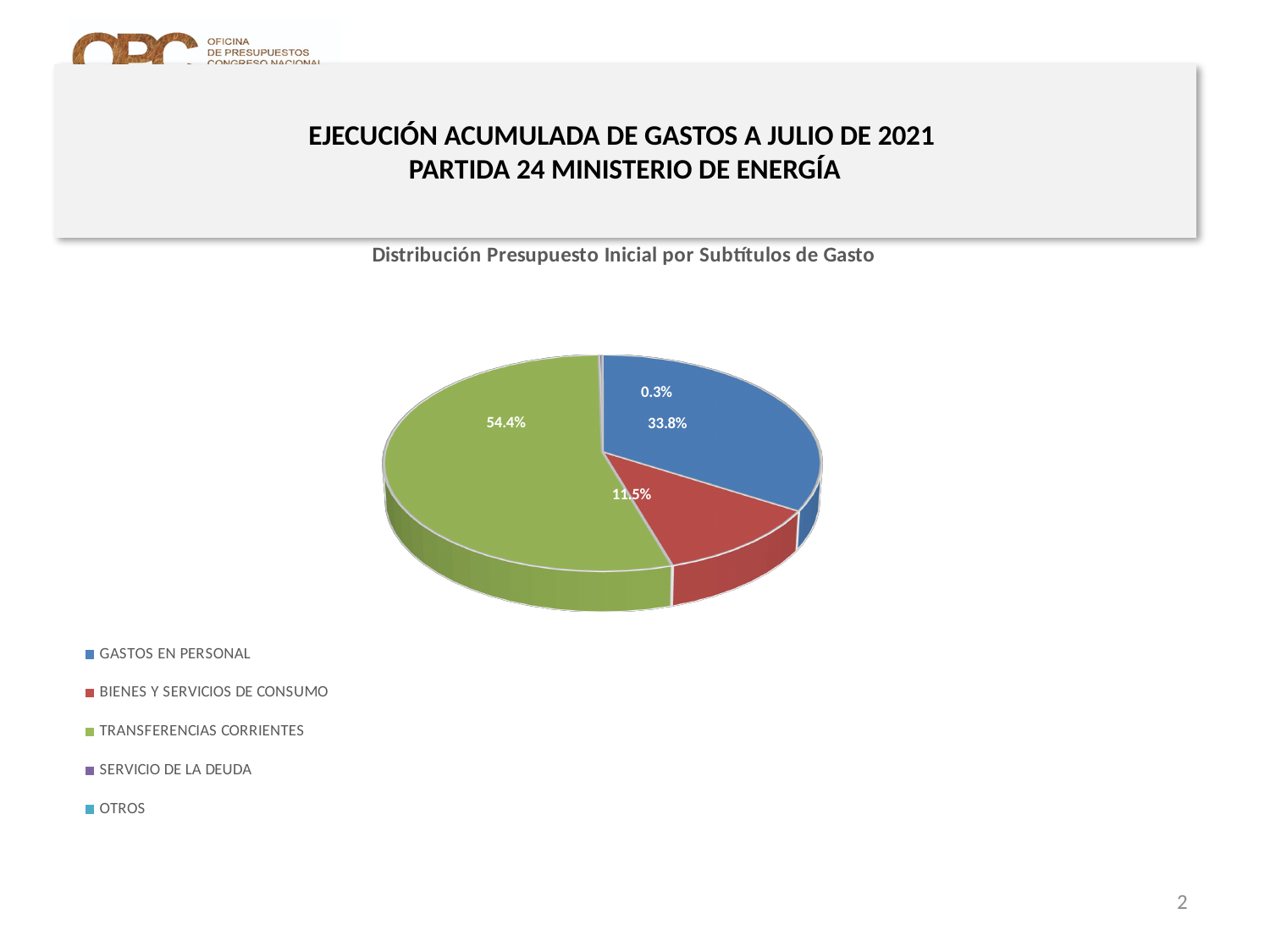
Which is larger, the share of GASTOS EN PERSONAL or the share of BIENES Y SERVICIOS DE CONSUMO? GASTOS EN PERSONAL What type of chart is shown on the slide? Pie chart What percentage of the pie chart corresponds to TRANSFERENCIAS CORRIENTES? 54.4% What is the title of the chart on the slide? Distribución Presupuesto Inicial por Subtítulos de Gasto Which category has the largest slice of the pie chart? TRANSFERENCIAS CORRIENTES What percentage is shown for BIENES Y SERVICIOS DE CONSUMO? 11.5% What colour represents TRANSFERENCIAS CORRIENTES in the pie chart? Green By how many percentage points does TRANSFERENCIAS CORRIENTES exceed GASTOS EN PERSONAL? 20.6 percentage points What is the smallest percentage label shown on the pie chart? 0.3% What is the difference between the shares of GASTOS EN PERSONAL and BIENES Y SERVICIOS DE CONSUMO? 22.3 percentage points What share does GASTOS EN PERSONAL have in the pie chart? 33.8% How many entries does the legend of the pie chart list? 5